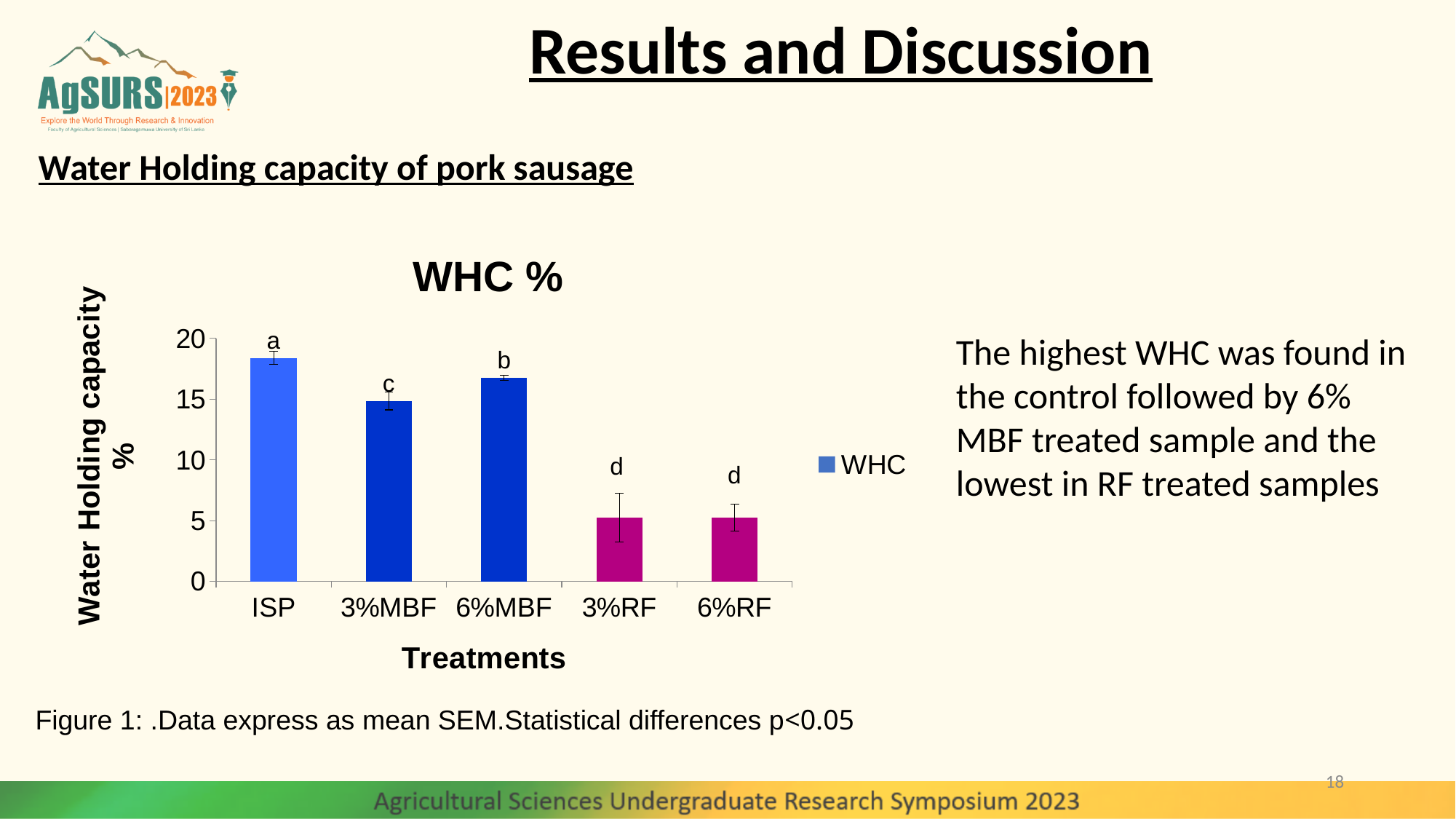
Which treatment has the highest WHC % value? ISP Which has a higher WHC % value, ISP or 3%MBF? ISP What kind of chart is shown on the slide? bar chart Which has a higher WHC % value, 3%MBF or 3%RF? 3%MBF How many series does the legend of the WHC % chart list? 1 Is the WHC % value for 6%MBF greater or less than 15? greater Is the WHC % value for ISP greater or less than 15? greater How many treatments are shown on the x axis of the WHC % chart? 5 What is the x-axis title of the chart? Treatments Is the WHC % value for 3%RF greater or less than 10? less What is the title of the chart? WHC % Which has a higher WHC % value, 3%MBF or 6%MBF? 6%MBF